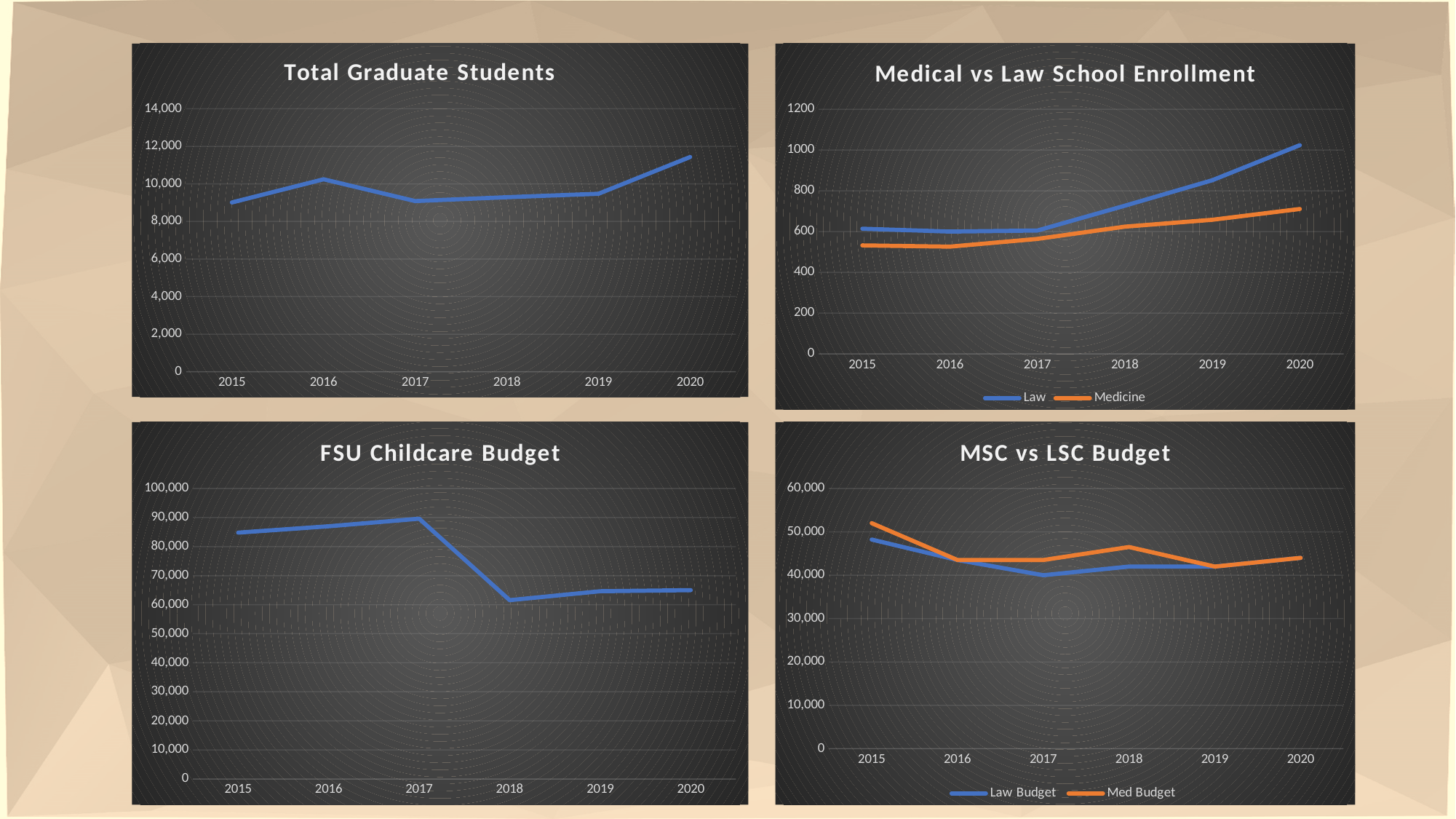
In the Total Graduate Students chart, which year has the highest value? 2020 In the FSU Childcare Budget chart, which year has the highest value? 2017 What kind of chart is the MSC vs LSC Budget chart? line chart In the Total Graduate Students chart, is the value for 2015 greater or less than 10,000? less How many years are plotted on the x axis of the Total Graduate Students chart? 6 In the Total Graduate Students chart, is the value for 2020 greater or less than 10,000? greater In the Medical vs Law School Enrollment chart, which series is higher in 2020, Law or Medicine? Law In the FSU Childcare Budget chart, is the value for 2018 greater or less than 70,000? less In the FSU Childcare Budget chart, which year has the lowest value? 2018 How many series does the legend of the Medical vs Law School Enrollment chart list? 2